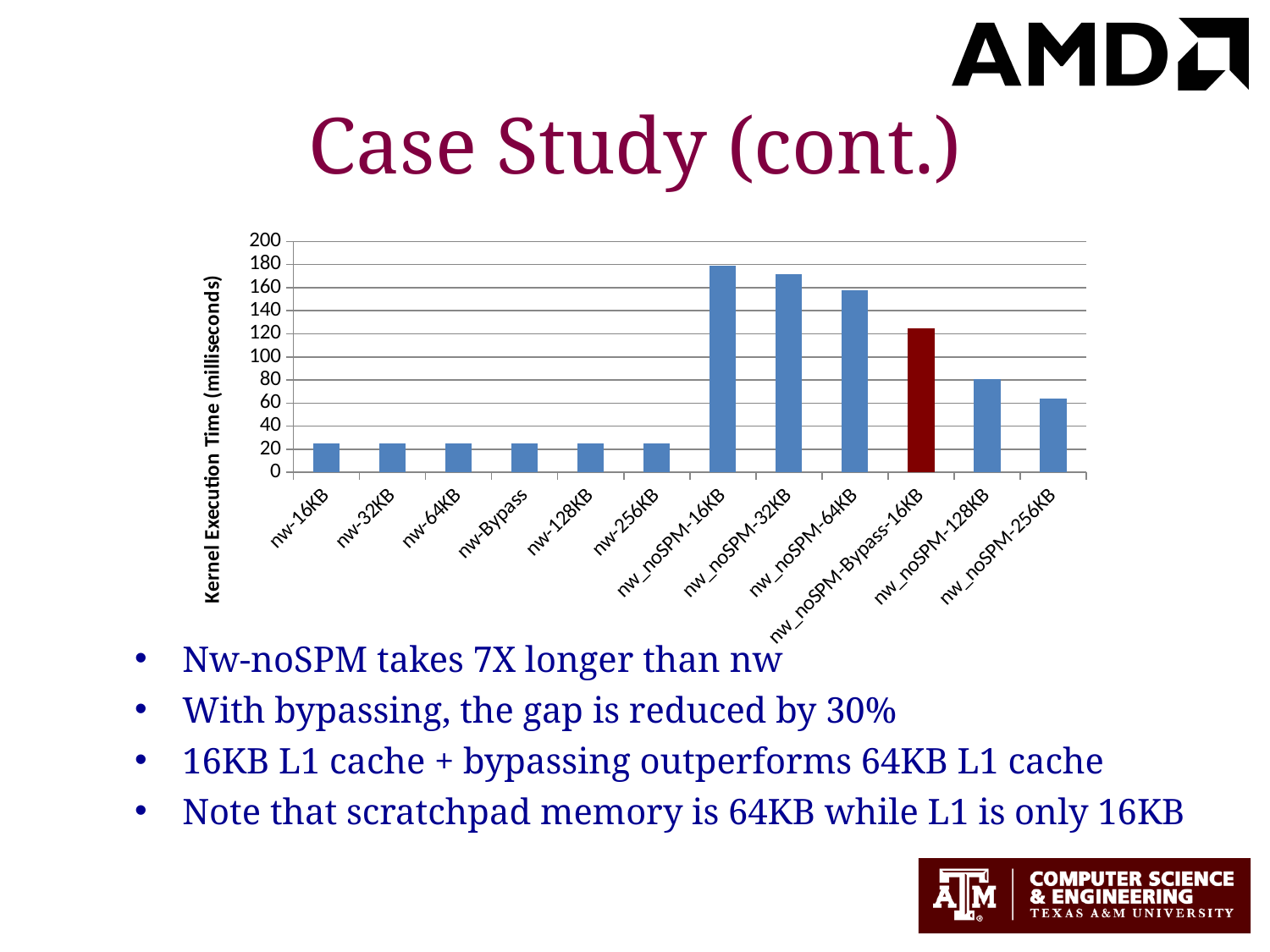
Is the value for nw_noSPM-Bypass-16KB greater or less than 100? greater Is the value for nw-16KB greater or less than 40? less Is the value for nw_noSPM-256KB greater or less than 80? less Which has the larger value, nw-256KB or nw_noSPM-256KB? nw_noSPM-256KB How many categories are plotted on the x axis of the chart? 12 Which has the larger value, nw_noSPM-128KB or nw_noSPM-32KB? nw_noSPM-32KB What kind of chart is shown on the slide? bar chart Which has the larger value, nw_noSPM-Bypass-16KB or nw_noSPM-64KB? nw_noSPM-64KB What is the label of the y axis of the chart? Kernel Execution Time (milliseconds) Which category's bar is drawn in dark red rather than blue? nw_noSPM-Bypass-16KB